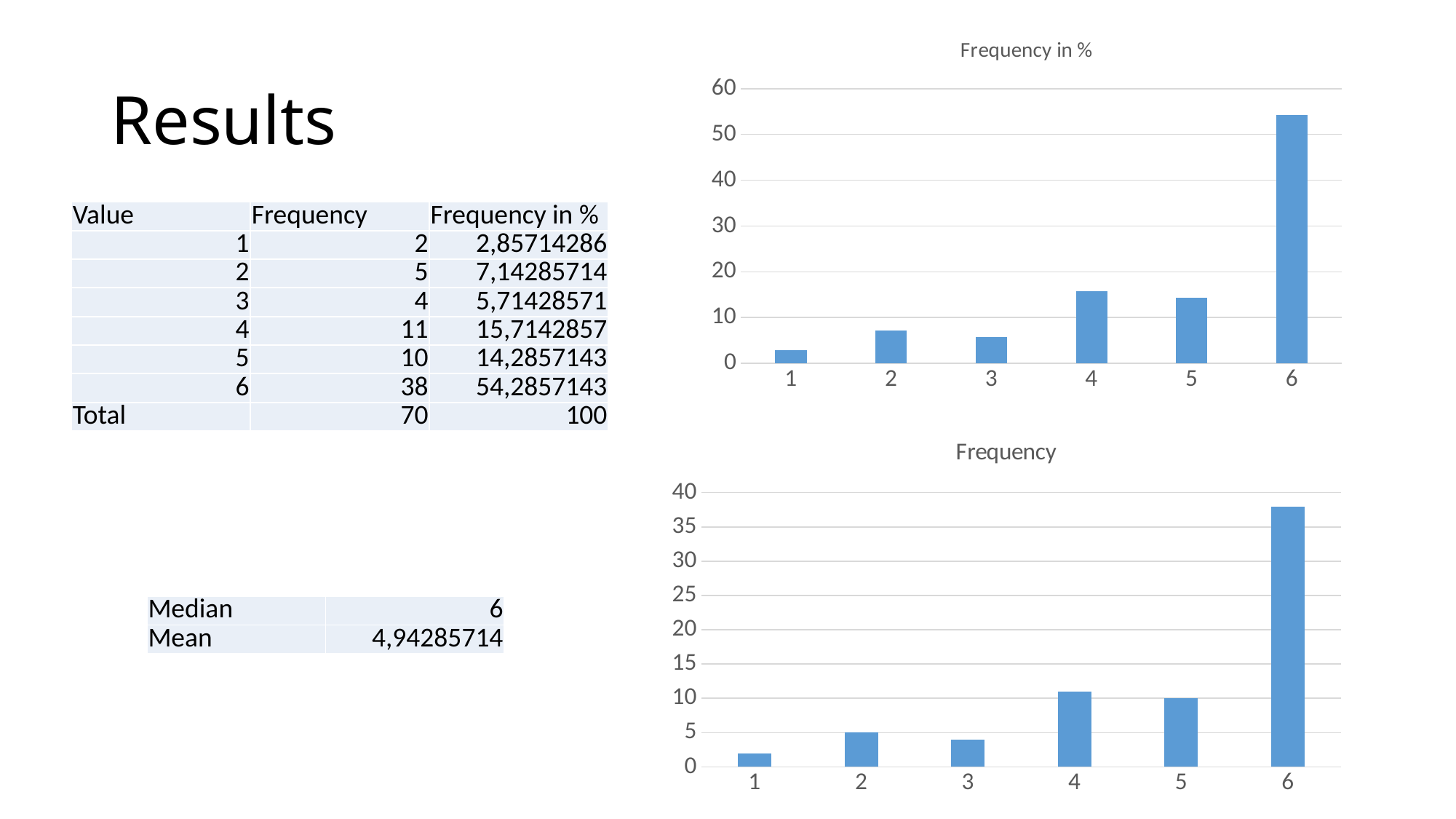
In the "Frequency" chart, which category has the lowest bar? 1 In the "Frequency" chart, what is the value for category 2? 5 In the "Frequency" chart, which category has the highest bar? 6 In the "Frequency in %" chart, which is larger, the value for category 2 or the value for category 3? 2 In the "Frequency in %" chart, which category has the highest bar? 6 In the "Frequency in %" chart, is the value for category 1 greater or less than 10? less In the "Frequency" chart, what is the value for category 6? 38 In the "Frequency" chart, how many categories are shown on the x axis? 6 In the "Frequency" chart, is the value for category 4 greater or less than 5? greater In the "Frequency in %" chart, is the value for category 6 greater or less than 50? greater In the "Frequency" chart, what is the value for category 5? 10 What type of chart is the "Frequency" chart? bar chart